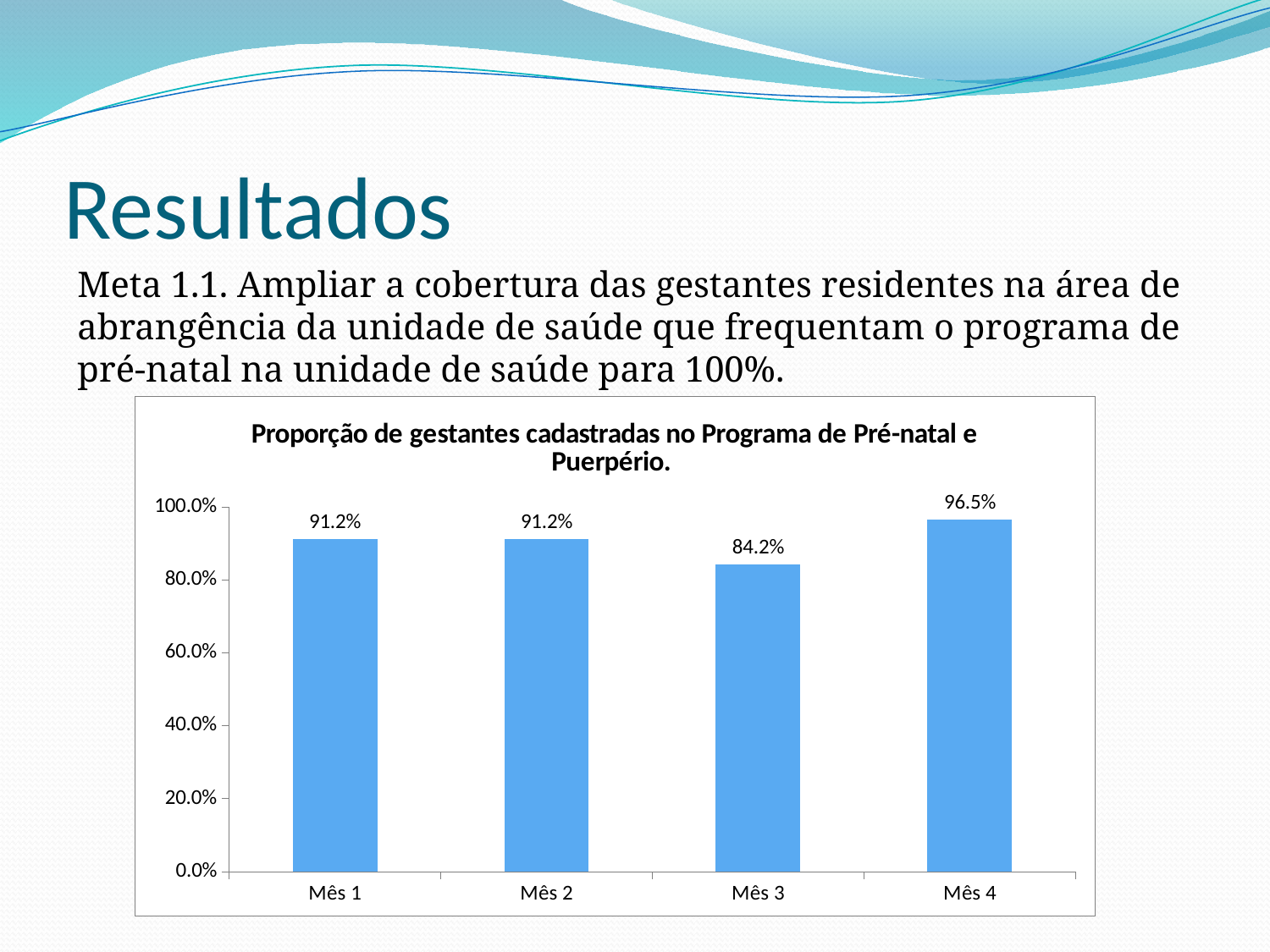
Which is larger, the value for Mês 2 or the value for Mês 3? Mês 2 What is the title of the chart? Proporção de gestantes cadastradas no Programa de Pré-natal e Puerpério. How many months are shown on the x axis? 4 What is the value for Mês 3? 84.2% Which month has the lowest value? Mês 3 What kind of chart is shown on the slide? bar chart What is the value for Mês 4? 96.5% What is the difference between the values for Mês 4 and Mês 3? 12.3% Which month has the highest value? Mês 4 What is the value for Mês 1? 91.2% Do the values rise or fall from Mês 3 to Mês 4? rise Is the value for Mês 3 greater or less than 80.0%? greater